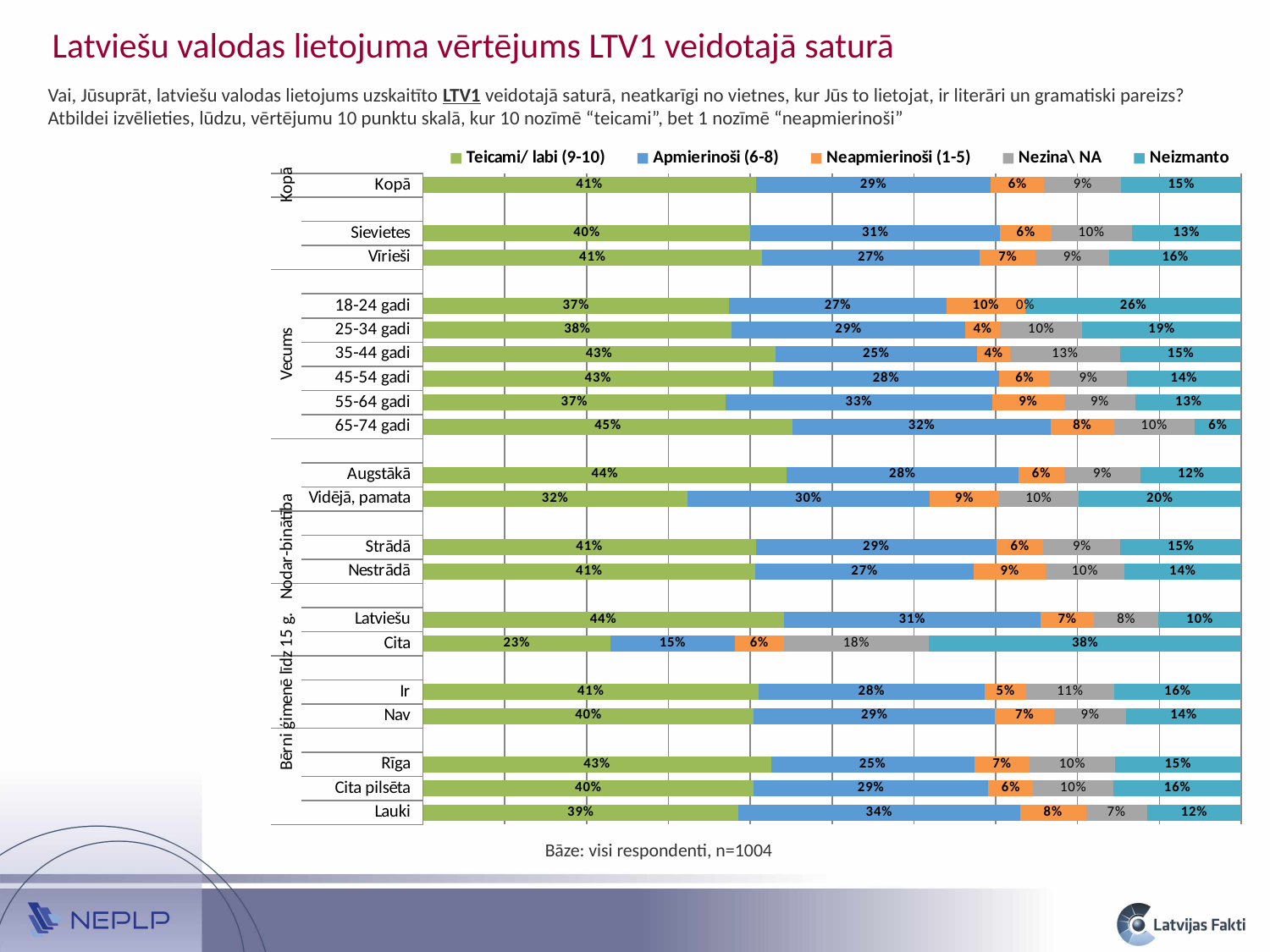
Which category has the highest Neizmanto value? Cita Which category has the lowest Teicami/ labi (9-10) value? Cita What is the value of Nezina\ NA for Cita? 18% What is the value of Neizmanto for 18-24 gadi? 26% What is the value of Teicami/ labi (9-10) for Kopā? 41% Which is larger: the Neapmierinoši (1-5) value for 18-24 gadi or for 25-34 gadi? 18-24 gadi What is the difference between the Teicami/ labi (9-10) and Apmierinoši (6-8) values for Kopā? 12 percentage points Which category has the highest Teicami/ labi (9-10) value? 65-74 gadi What is the total of the stacked bar for Kopā? 100% What is the value of Apmierinoši (6-8) for Lauki? 34% How many series does the legend list? 5 What type of chart is shown on the slide? Stacked bar chart